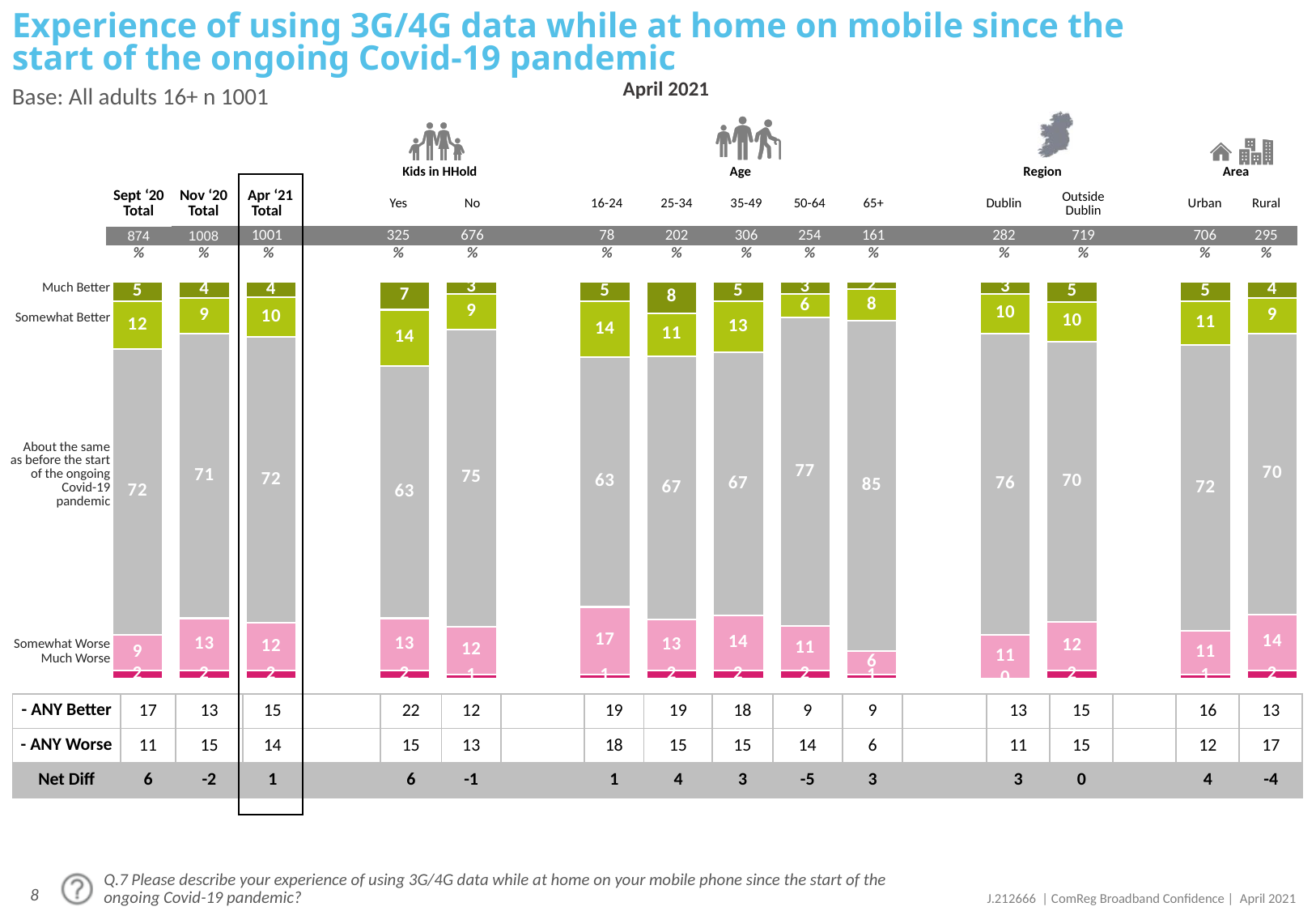
What is the base size shown for the Apr '21 Total? 1001 Which has the larger Somewhat Better value, Urban or Rural? Urban How many stacked bars are shown in the chart? 14 What percentage of the Apr '21 Total said their experience was about the same as before the start of the pandemic? 72 How many response categories are stacked in each bar? 5 What kind of chart is shown on the slide? Stacked bar chart What is the Somewhat Better value for the Kids in HHold 'Yes' group? 14 What is the difference between the Somewhat Worse value for 16-24 and for 65+? 11 What is the Net Diff value for the Rural group? -4 Which group has the highest 'About the same' value? 65+ What is the ANY Better value for the Kids in HHold 'Yes' group? 22 Which group has the lowest Somewhat Worse value? 65+